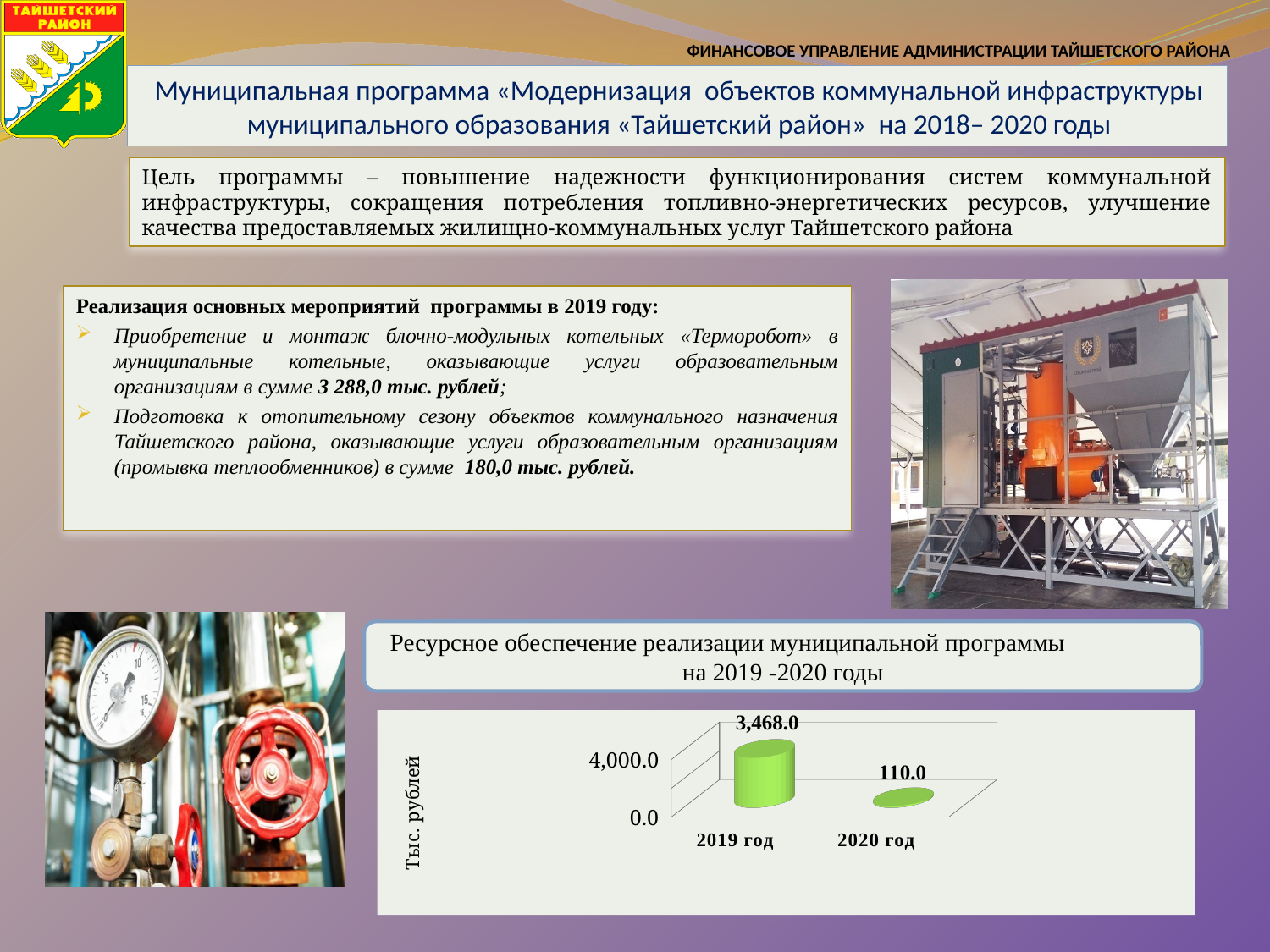
Do the values rise or fall from 2019 год to 2020 год? fall What is the value for 2020 год in the chart? 110.0 Is the value for 2019 год greater or less than 4,000.0? less What is the title shown above the chart? Ресурсное обеспечение реализации муниципальной программы на 2019 -2020 годы What is the difference between the values for 2019 год and 2020 год? 3,358.0 What is the value for 2019 год in the chart? 3,468.0 Which year has the highest value in the chart? 2019 год What unit is shown on the vertical axis label of the chart? Тыс. рублей Which is larger, the value for 2019 год or for 2020 год? 2019 год What kind of chart is shown on the slide? bar chart Which year has the lowest value in the chart? 2020 год How many categories are shown in the chart? 2